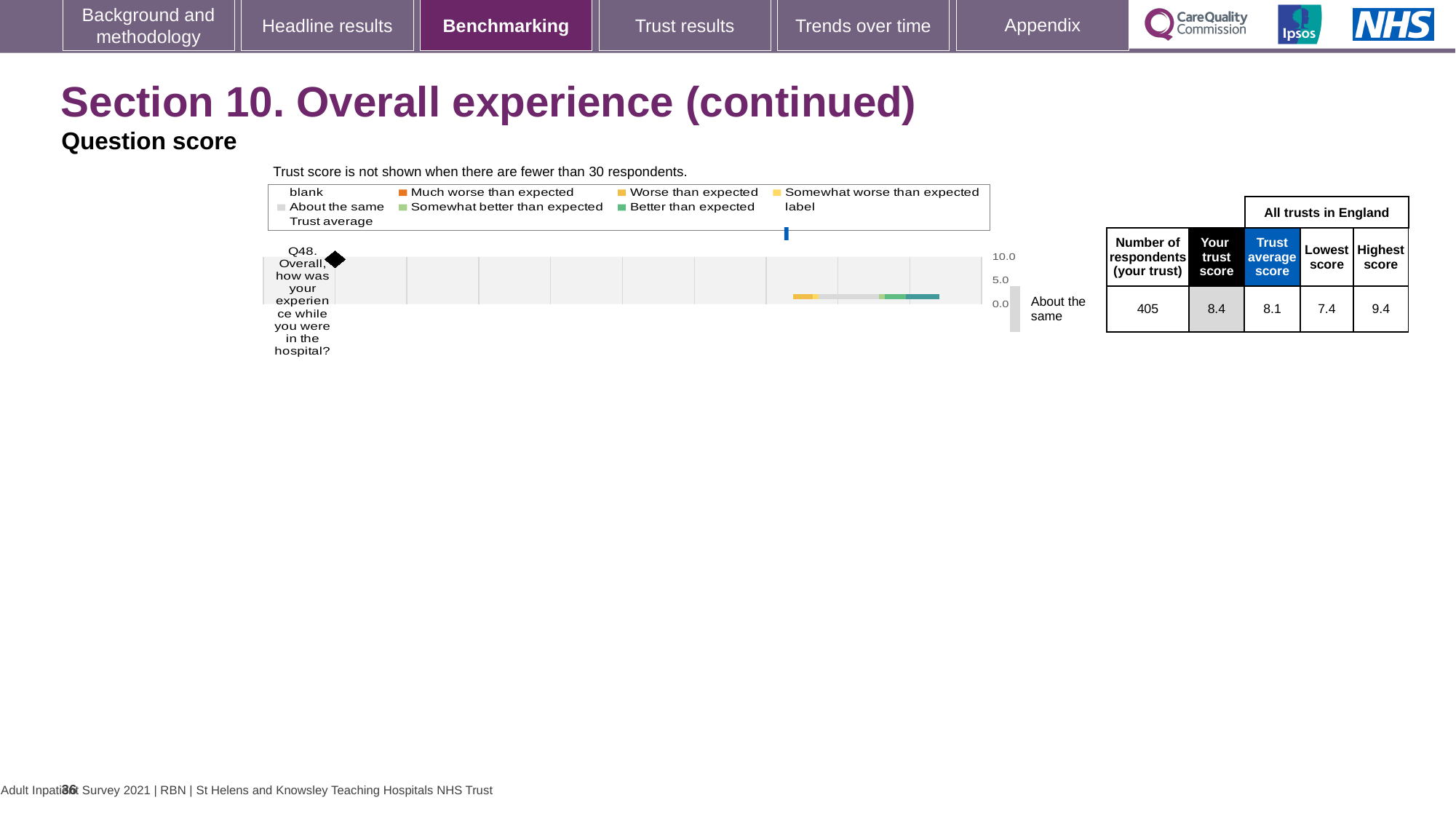
Which is larger for Q48: the trust's score or the trust average score? the trust's score Which benchmarking category is the trust's Q48 score placed in? About the same What is the trust average score for Q48 across all trusts in England? 8.1 Which question is plotted in the benchmarking chart? Q48. Overall, how was your experience while you were in the hospital? What kind of chart is used to show the Q48 benchmarking result? bar chart What is the highest value shown on the chart's score axis? 10.0 How many respondents from the trust answered Q48? 405 What is the trust's score for Q48 according to the table next to the chart? 8.4 What is the highest score for Q48 among all trusts in England? 9.4 What is the difference between the highest score and the lowest score for Q48 among all trusts in England? 2.0 What is the lowest score for Q48 among all trusts in England? 7.4 How many questions are plotted in the benchmarking chart? 1